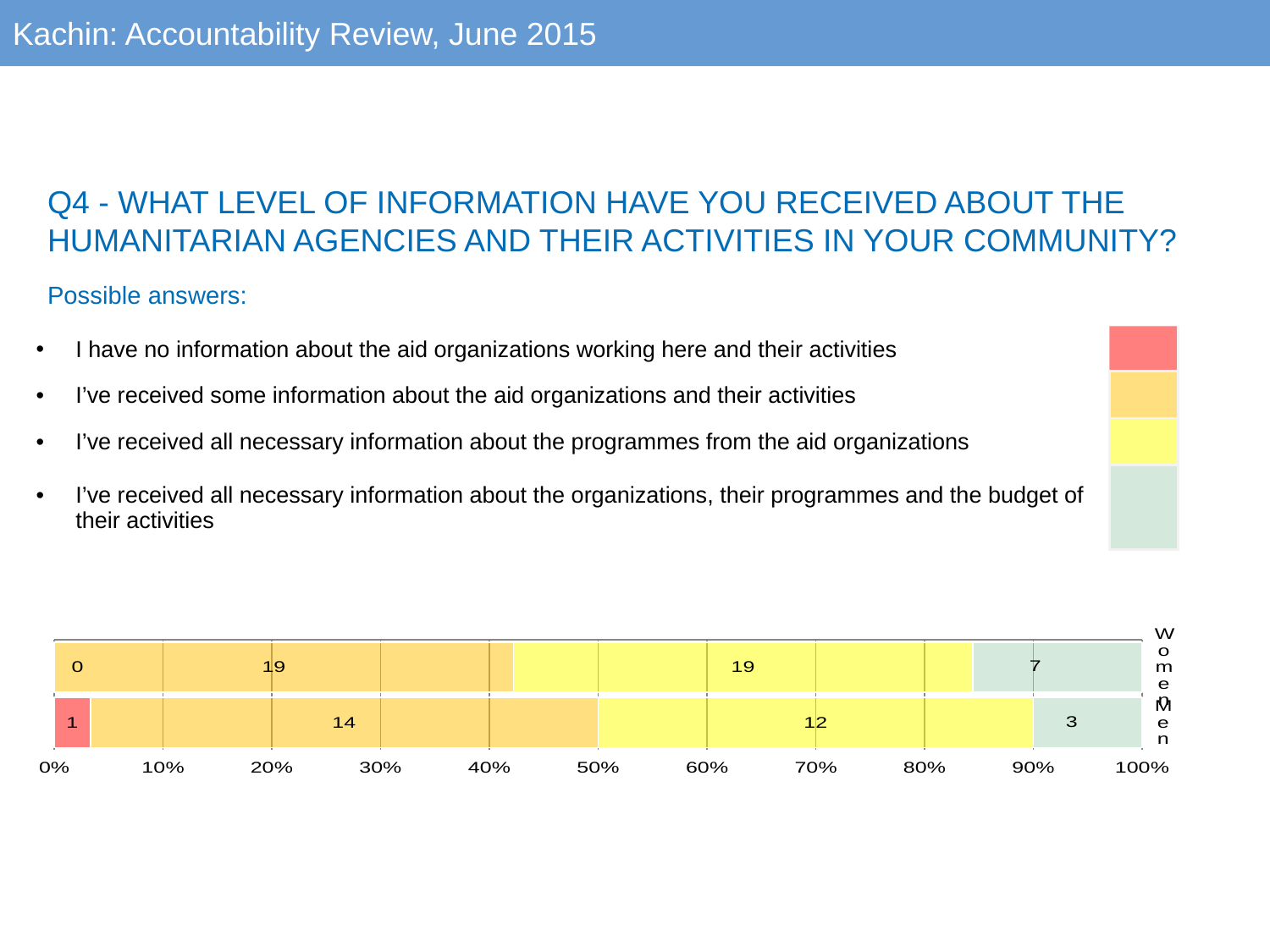
What is the total of all segments in the Men bar? 30 Which colour represents the answer 'I have no information about the aid organizations working here and their activities'? red What kind of chart is shown on the slide? bar chart Which is larger, the green segment for Women or the green segment for Men? Women What is the difference between the orange segment for Women and the orange segment for Men? 5 What is the value of the green segment for Women? 7 What is the value of the red segment for Men? 1 What is the value of the red segment for Women? 0 What is the value of the orange segment for Women? 19 What is the value of the yellow segment for Men? 12 How many categories (bars) does the chart show? 2 What is the total of all segments in the Women bar? 45